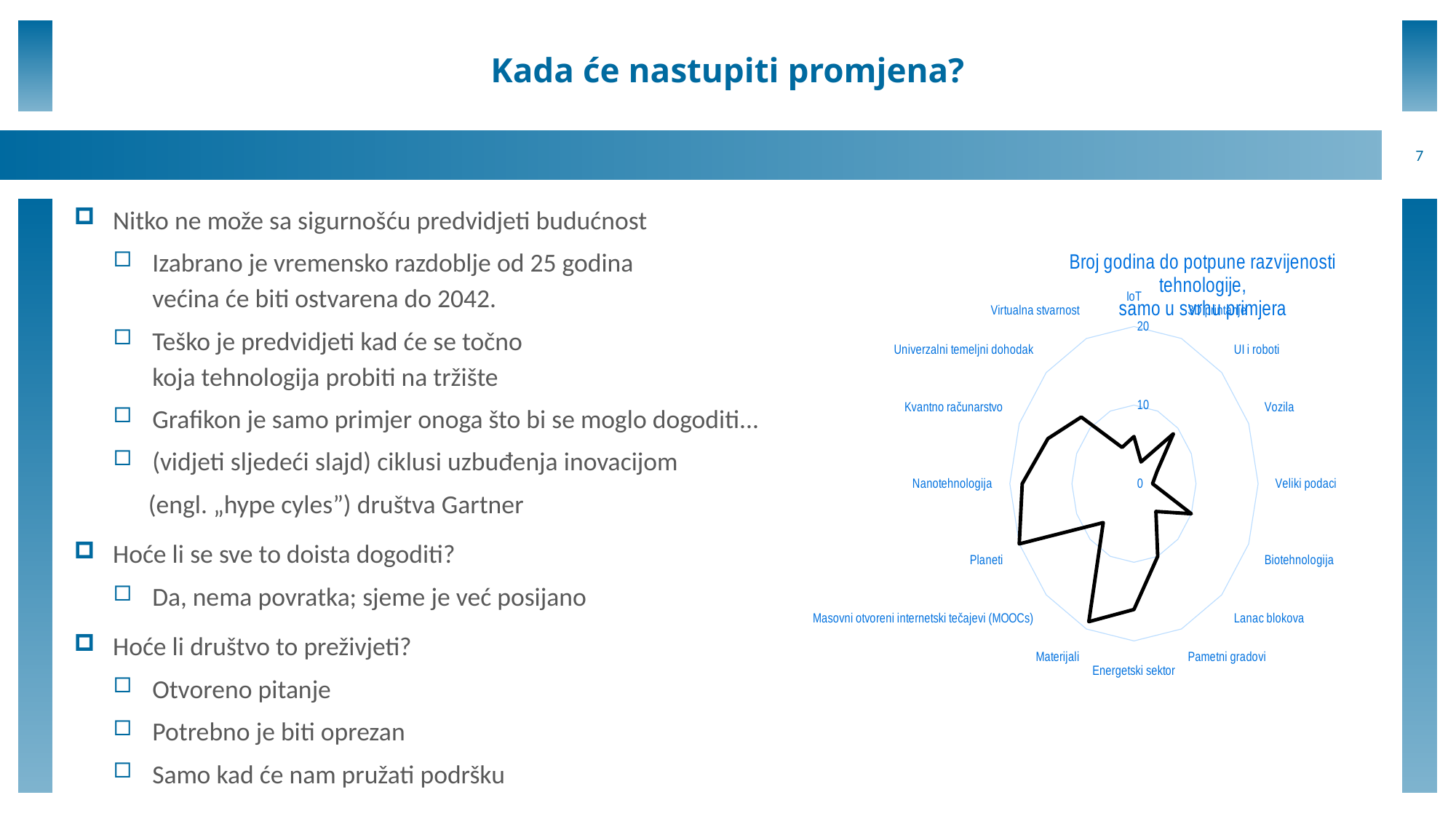
Is the value for Energetski sektor greater or less than 10? greater Is the value for Materijali greater or less than 10? greater Is the value for Lanac blokova greater or less than 10? less Which has the larger value, Planeti or Veliki podaci? Planeti What is the title of the chart? Broj godina do potpune razvijenosti tehnologije, samo u svrhu primjera What is the highest value marked on the chart's axis? 20 What kind of chart is shown on the slide? Radar chart Which has the larger value, Materijali or IoT? Materijali